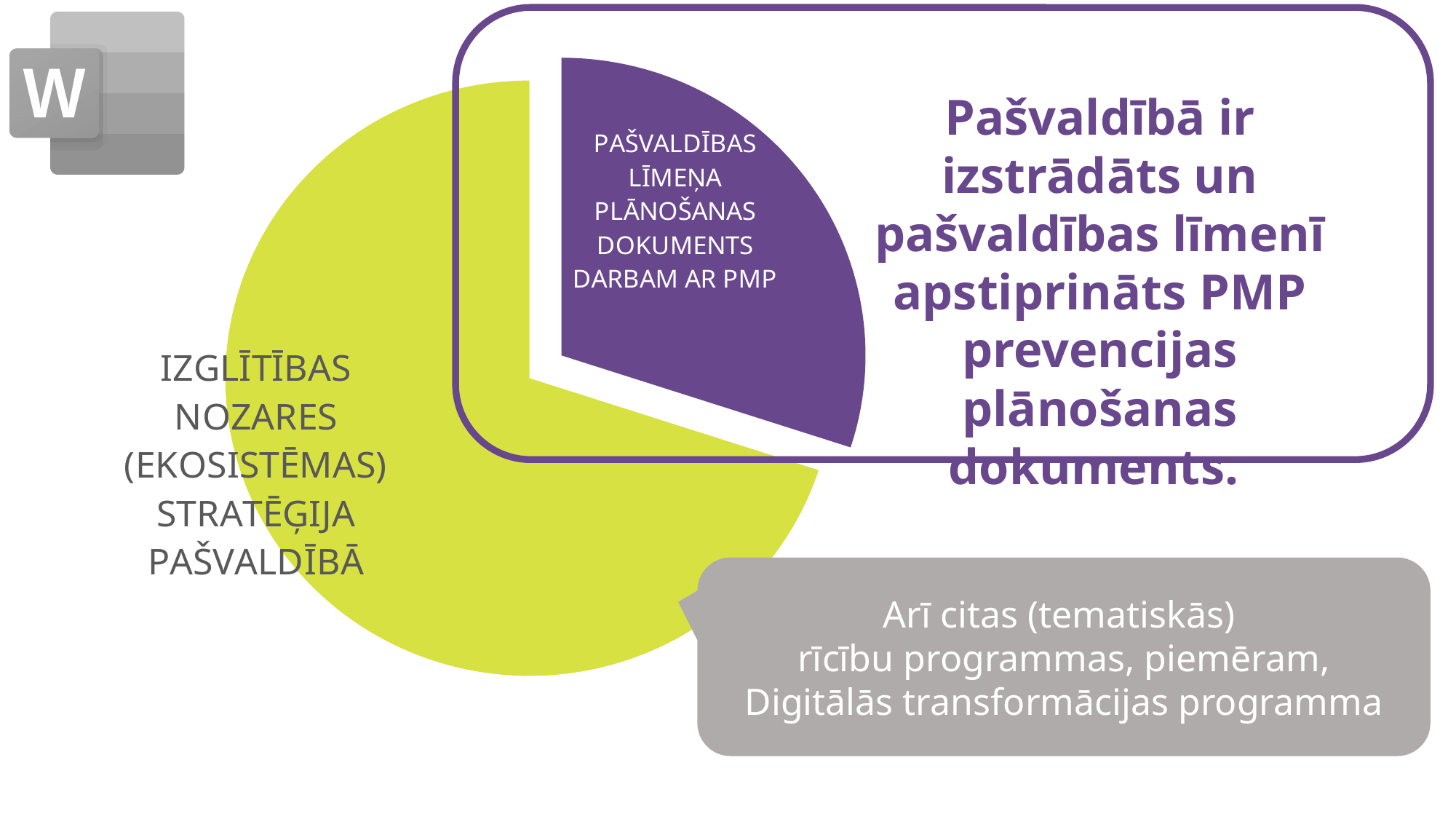
What colour is the slice labelled PAŠVALDĪBAS LĪMEŅA PLĀNOŠANAS DOKUMENTS DARBAM AR PMP? purple Which slice is larger: IZGLĪTĪBAS NOZARES (EKOSISTĒMAS) STRATĒĢIJA PAŠVALDĪBĀ or PAŠVALDĪBAS LĪMEŅA PLĀNOŠANAS DOKUMENTS DARBAM AR PMP? IZGLĪTĪBAS NOZARES (EKOSISTĒMAS) STRATĒĢIJA PAŠVALDĪBĀ Which slice of the pie chart is the largest? IZGLĪTĪBAS NOZARES (EKOSISTĒMAS) STRATĒĢIJA PAŠVALDĪBĀ What colour is the slice labelled IZGLĪTĪBAS NOZARES (EKOSISTĒMAS) STRATĒĢIJA PAŠVALDĪBĀ? yellow-green Which slice of the pie chart is the smallest? PAŠVALDĪBAS LĪMEŅA PLĀNOŠANAS DOKUMENTS DARBAM AR PMP What kind of chart is shown on the slide? pie chart How many slices does the pie chart have? 2